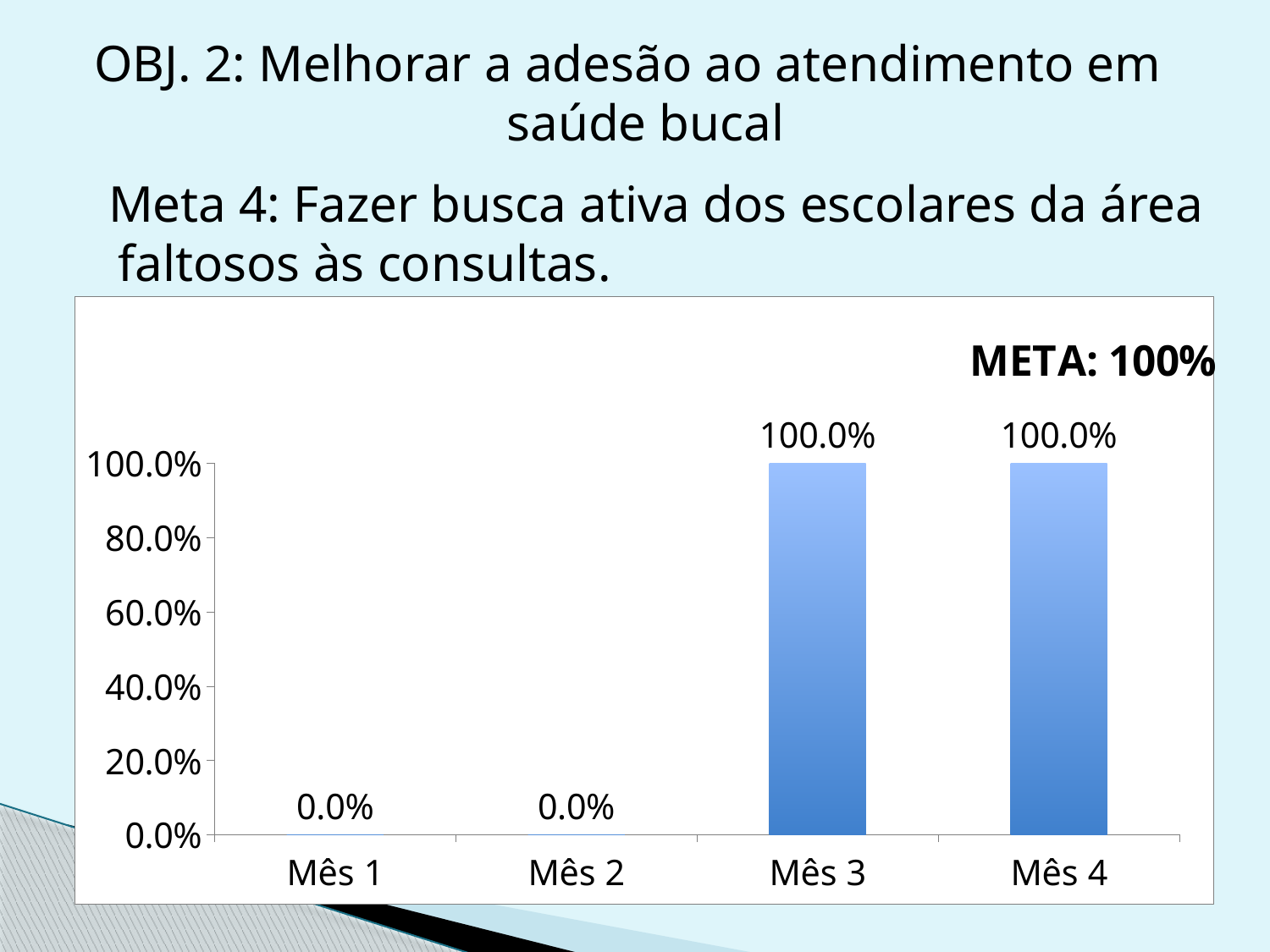
Which category has the lowest value, Mês 2 or Mês 3? Mês 2 What is the highest tick value shown on the y axis? 100.0% Do the values rise or fall from Mês 2 to Mês 3? rise How many categories are shown on the x axis? 4 What target (META) is stated on the chart? 100% What is the value for Mês 1? 0.0% What is the value for Mês 3? 100.0% Is the value for Mês 4 greater or less than 80.0%? greater What is the difference between the values for Mês 3 and Mês 1? 100.0% What is the value for Mês 4? 100.0% What is the value for Mês 2? 0.0% What kind of chart is shown on the slide? bar chart